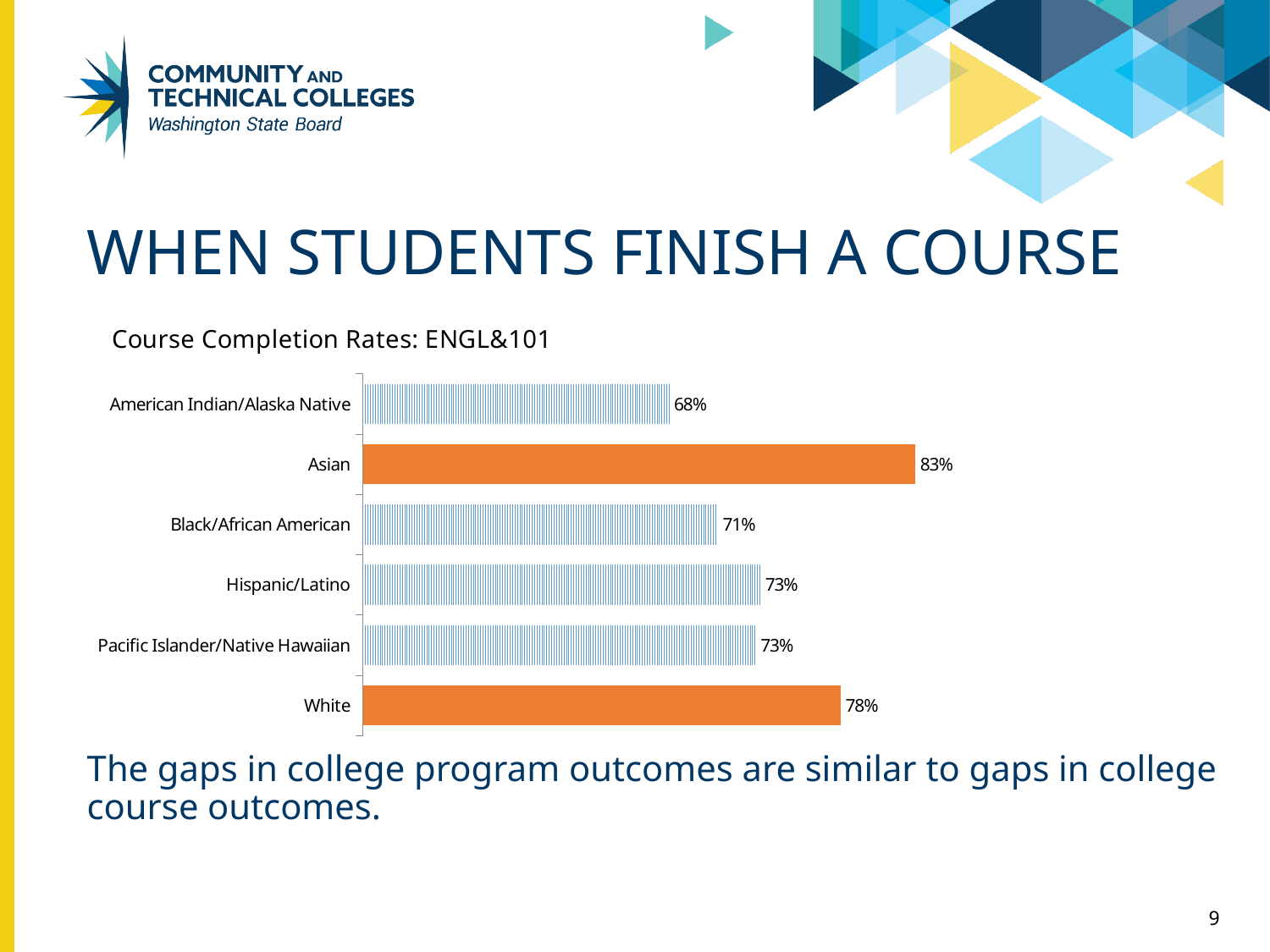
What type of chart is shown on the slide? Bar chart Which group has a higher completion rate, Black/African American or Hispanic/Latino? Hispanic/Latino What is the course completion rate for White students? 78% What is the course completion rate for Black/African American students? 71% How many groups are shown in the chart? 6 Which group has the lowest course completion rate? American Indian/Alaska Native What is the course completion rate for Asian students in ENGL&101? 83% Which group has the highest course completion rate? Asian What is the title of the chart? Course Completion Rates: ENGL&101 What is the difference between the completion rates for Asian and White students? 5% What is the difference between the completion rates for White and American Indian/Alaska Native students? 10% What is the course completion rate for American Indian/Alaska Native students? 68%